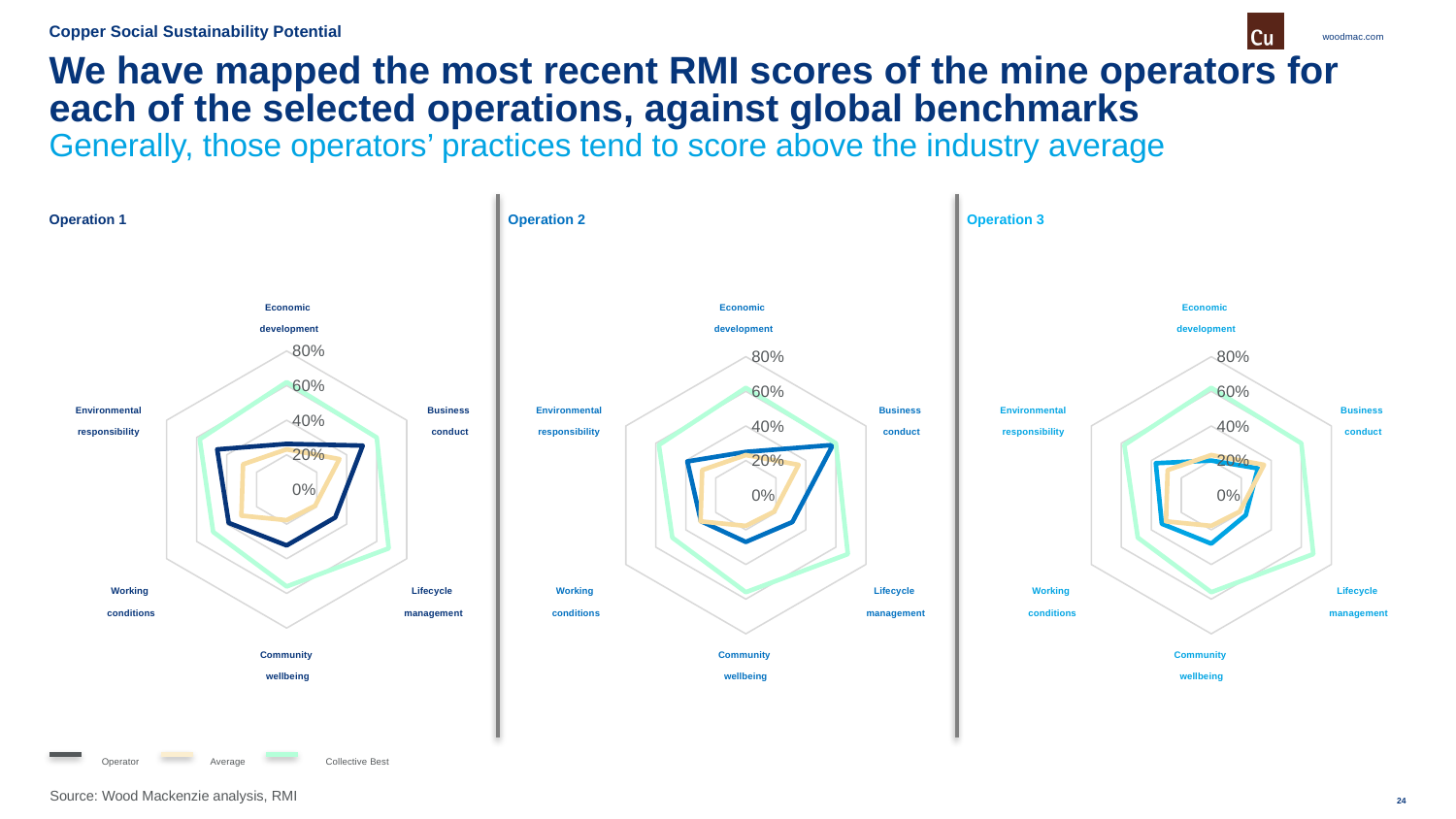
In the Operation 2 chart, is the Operator value for Community wellbeing greater or less than 60%? less How many radar charts are shown on the slide? 3 In the Operation 3 chart, is the Operator value for Economic development greater or less than 40%? less What kind of chart is used for Operation 1? Radar chart In the Operation 1 chart, is the Collective Best value for Lifecycle management greater or less than 60%? greater In the Operation 1 chart, which series is higher for Lifecycle management, Operator or Collective Best? Collective Best In the Operation 3 chart, which series is higher for Environmental responsibility, Operator or Average? Operator What are the three series named in the legend? Operator, Average, Collective Best How many series does the legend list for the charts? 3 How many categories (axes) does the Operation 2 chart have? 6